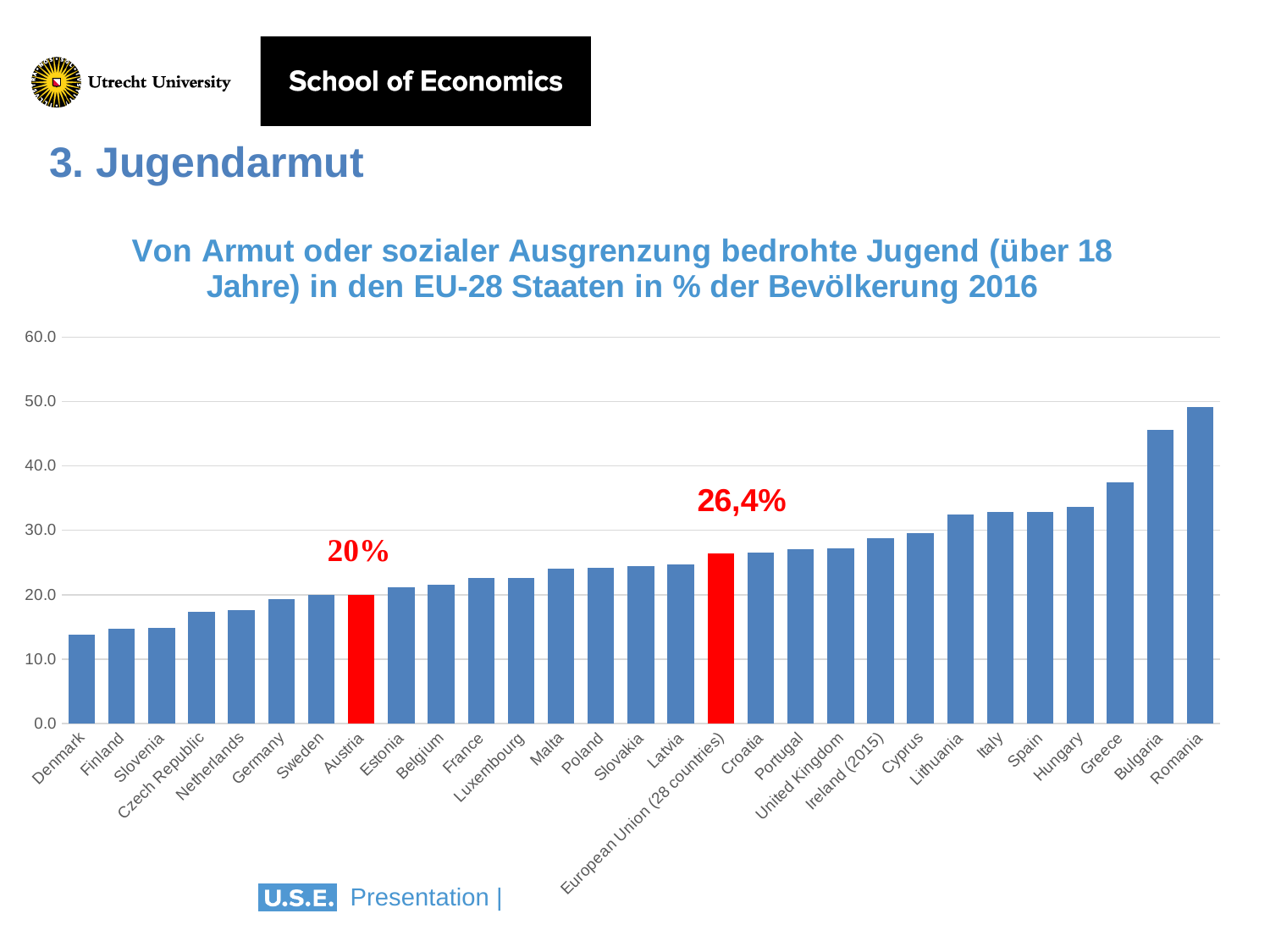
Which country has the lowest bar in the chart? Denmark By how many percentage points does the labelled value for the European Union (28 countries) exceed the labelled value for Austria? 6,4 Do the values rise or fall moving from left to right along the x axis? Rise Is the value for Croatia greater or less than 20? greater Is the value for Romania greater or less than 40? greater What value is labelled on the bar for European Union (28 countries)? 26,4% Which two bars are coloured red in the chart? Austria and European Union (28 countries) What kind of chart is shown on the slide? Bar chart Is the value for Netherlands greater or less than 20? less Which has a higher value, Greece or Italy? Greece Which country has the highest bar in the chart? Romania What value is labelled on the bar for Austria? 20%